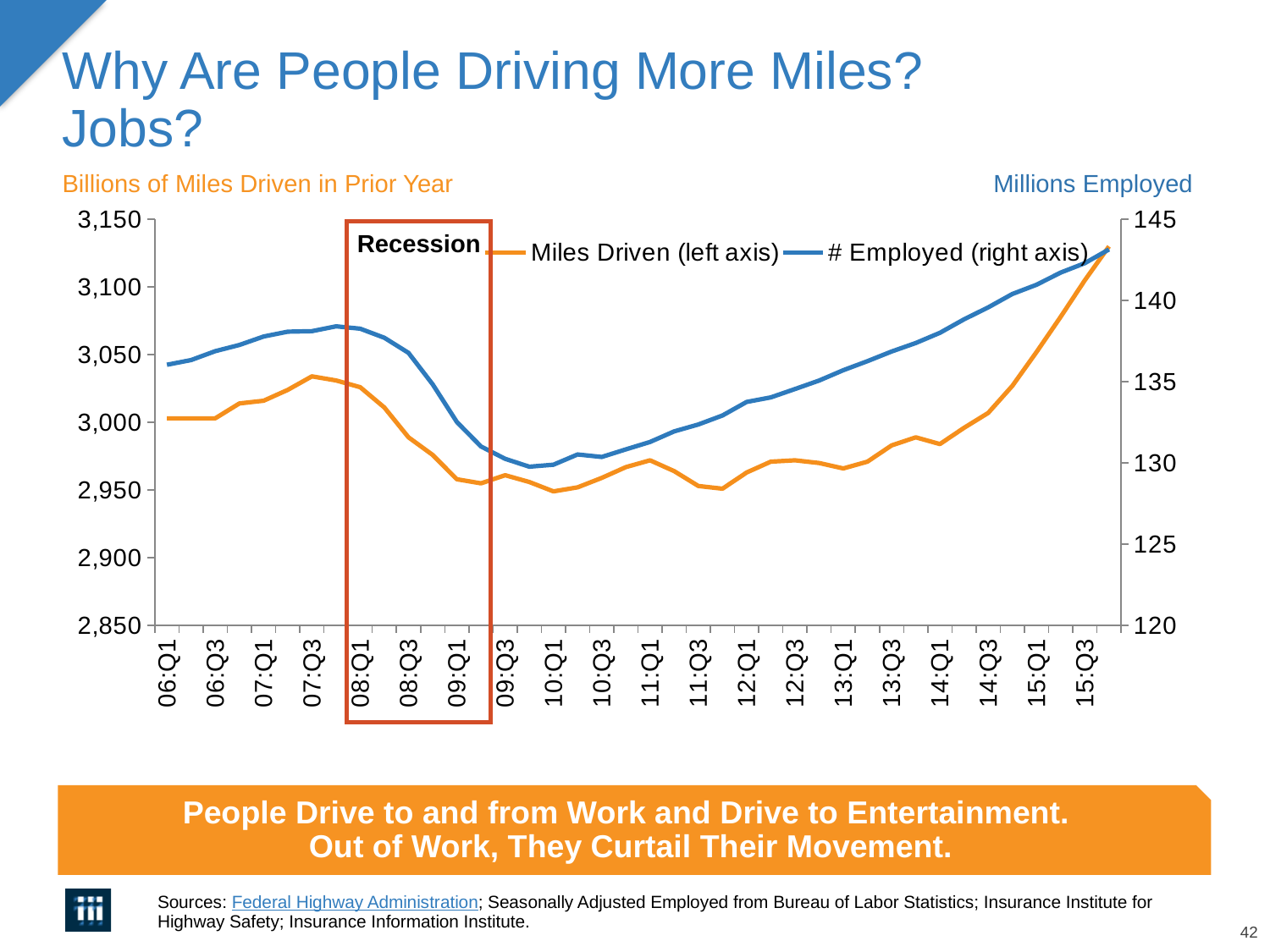
What is the title of the left axis? Billions of Miles Driven in Prior Year Is the value for # Employed at 06:Q1 greater or less than 135? greater What kind of chart is shown on the slide? Line chart At which quarter does the Miles Driven series reach its highest value? 15:Q4 Does the # Employed series rise or fall between 08:Q1 and 09:Q3? Fall Which series is plotted against the right axis? # Employed Is the value for Miles Driven at 14:Q1 greater or less than 3,000? less Does the Miles Driven series rise or fall between 14:Q1 and 15:Q3? Rise Is the value for # Employed at 08:Q1 greater or less than 140? less How many series does the chart's legend list? 2